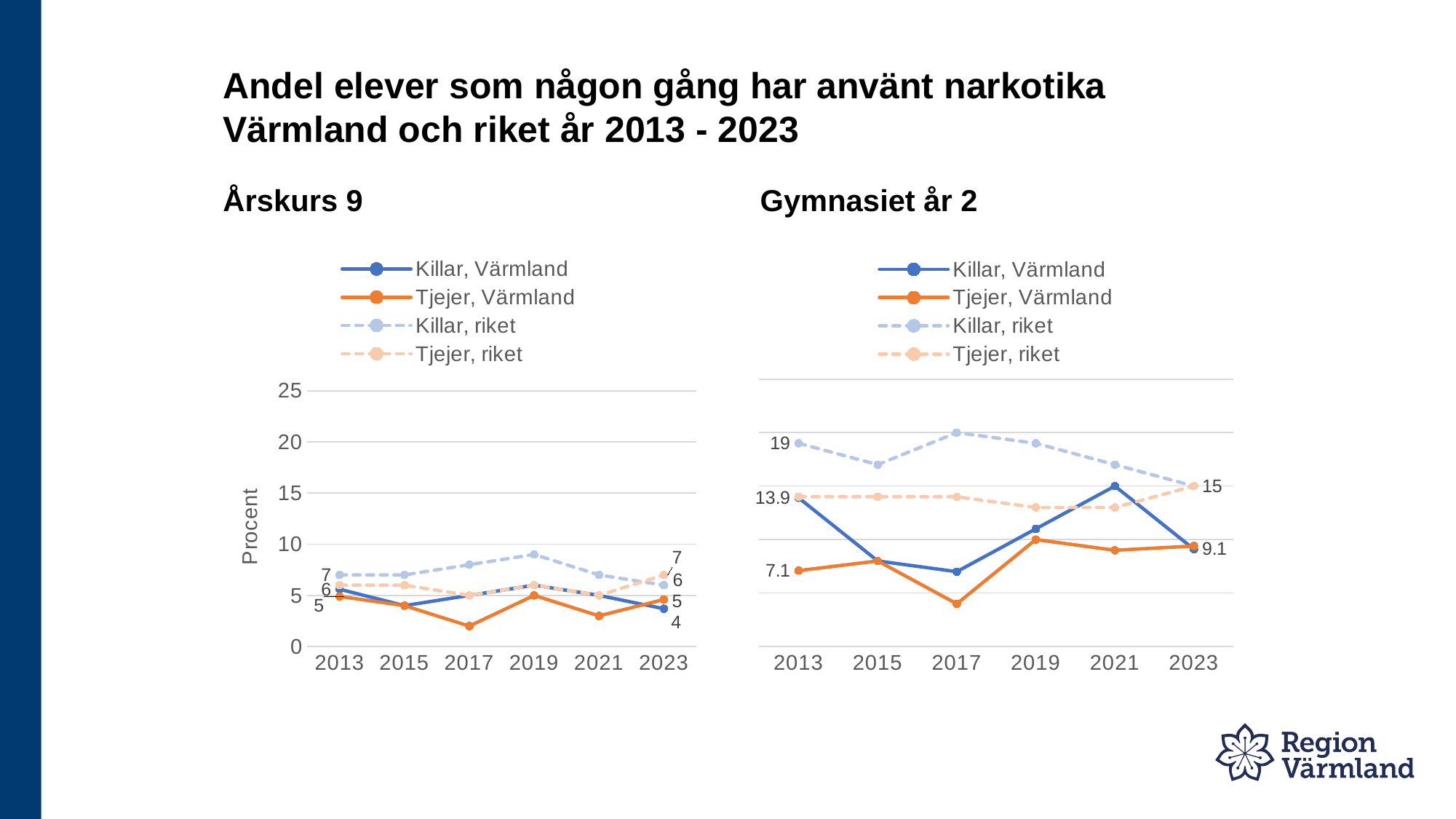
In the Gymnasiet år 2 chart, what is the value for Tjejer, Värmland in 2013? 7.1 In the Årskurs 9 chart, what is the value for Killar, Värmland in 2023? 4 In the Årskurs 9 chart, which series has the highest value in 2023? Tjejer, riket How many years are shown on the x axis of the Årskurs 9 chart? 6 What kind of chart is the Årskurs 9 chart? line chart In the Gymnasiet år 2 chart, what is the difference between Killar, riket and Tjejer, Värmland in 2013? 11.9 In the Gymnasiet år 2 chart, what is the value for Killar, riket in 2013? 19 In the Gymnasiet år 2 chart, is the value for Killar, riket in 2015 greater or less than 15? greater In the Årskurs 9 chart, what is the value for Tjejer, riket in 2023? 7 What is the label on the y axis of the Årskurs 9 chart? Procent In the Gymnasiet år 2 chart, what is the value for Tjejer, riket in 2023? 15 How many series does the legend of the Gymnasiet år 2 chart list? 4